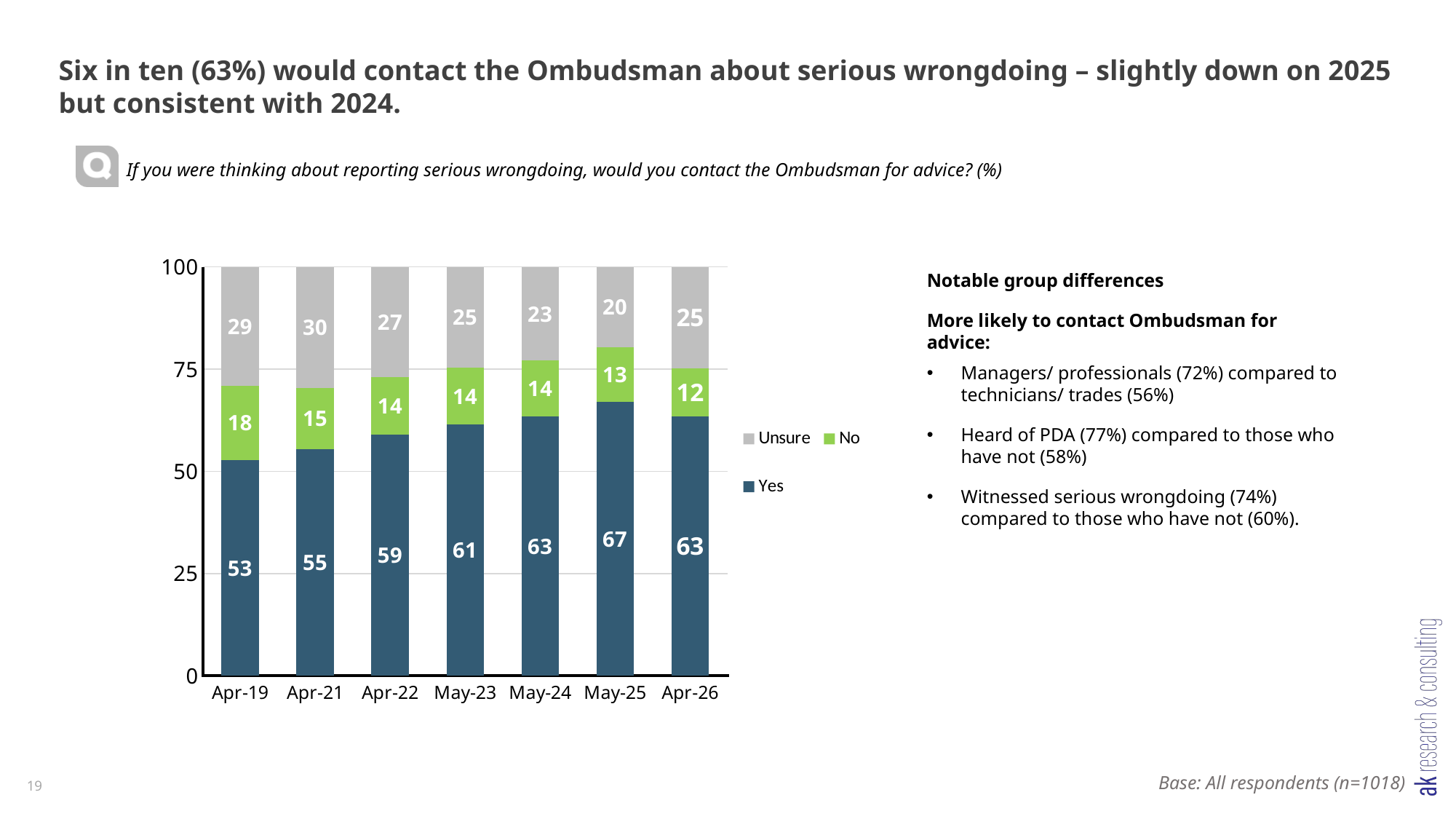
In which period is the Yes value highest? May-25 What is the difference between the Yes values for May-25 and Apr-26? 4 How many series does the legend list? 3 In which period is the No value lowest? Apr-26 What is the value for Yes in Apr-26? 63 Does the Yes value rise or fall from Apr-19 to May-25? Rise What is the value for No in May-25? 13 What is the value for Unsure in Apr-21? 30 Which colour represents the Yes series? Dark blue How many periods are shown on the x axis? 7 Which is larger, the Unsure value for Apr-19 or for May-24? Apr-19 What kind of chart is shown? Stacked bar chart